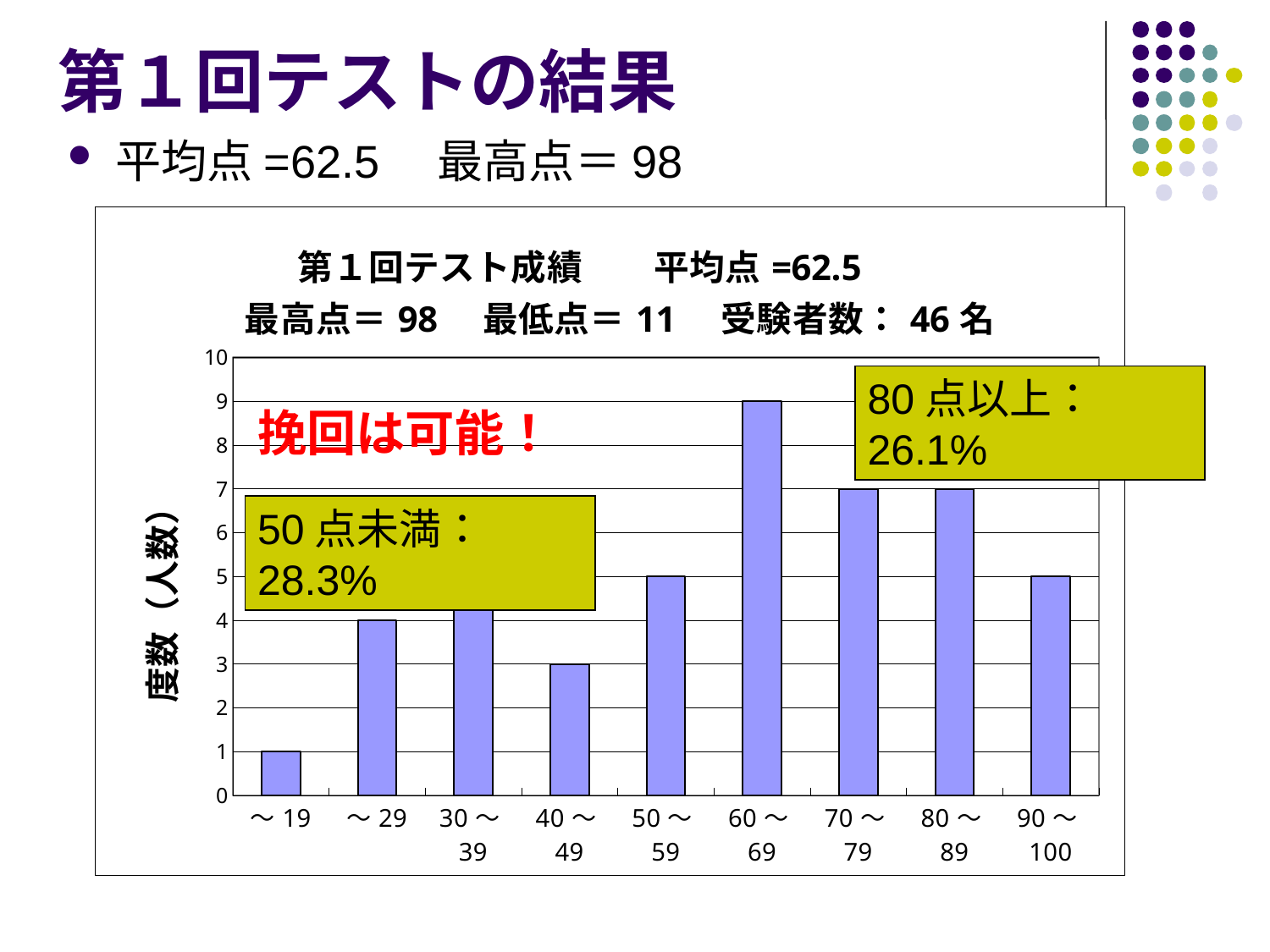
Is the value for 70～79 greater or less than 5? greater What is the frequency for the 40～49 score range? 3 Which score range has the lowest frequency? ～19 Which has a higher frequency, 50～59 or 40～49? 50～59 What is the frequency for the ～19 score range? 1 How many score-range categories are shown on the x axis? 9 What type of chart is shown on the slide? bar chart What is the frequency (number of people) for the 60～69 score range? 9 What is the difference between the frequency for 60～69 and the frequency for ～19? 8 What is the label on the y axis of the chart? 度数（人数） What is the frequency for the 90～100 score range? 5 Which score range has the highest frequency? 60～69